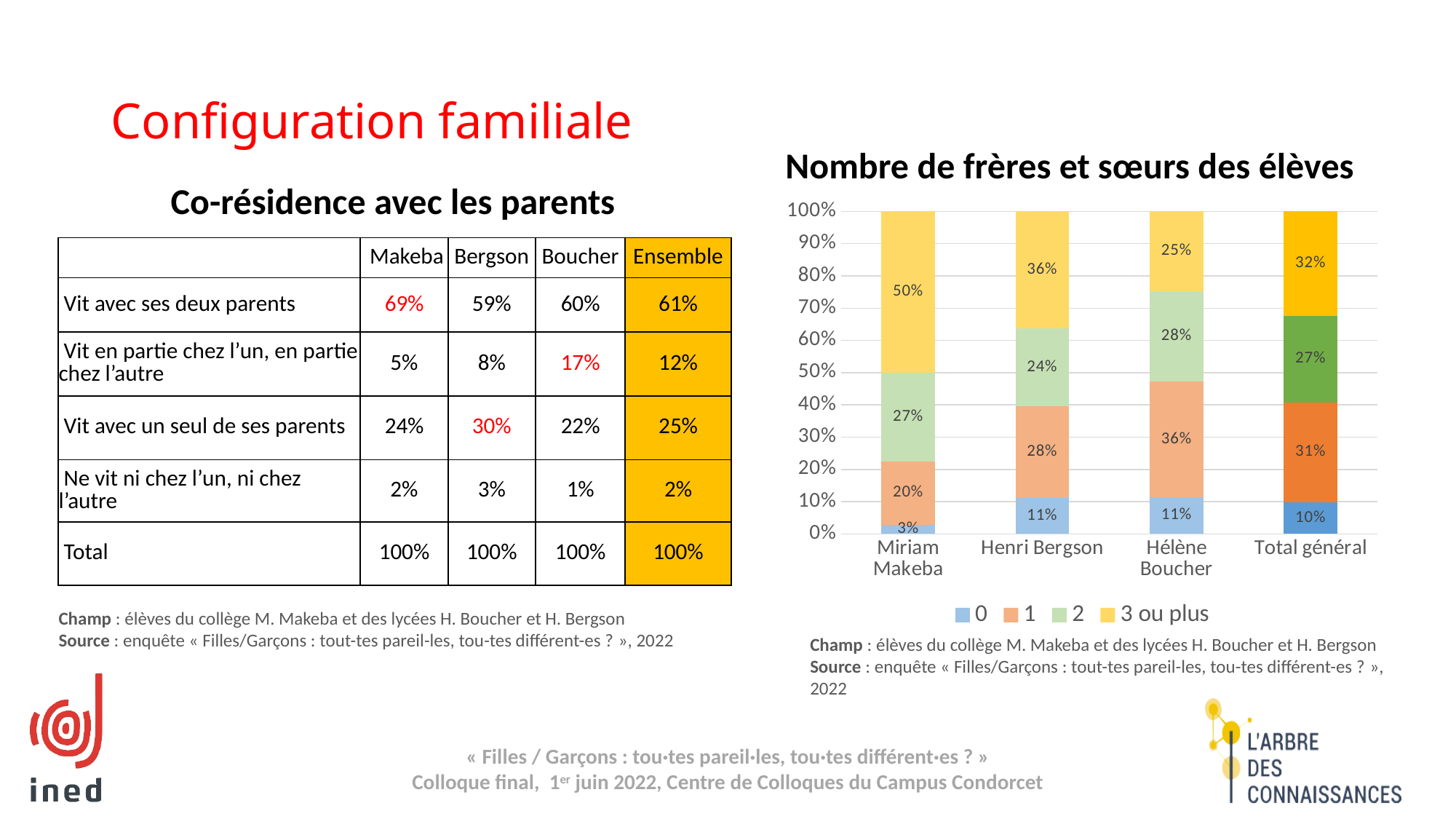
How many categories are shown on the x axis of the chart 'Nombre de frères et sœurs des élèves'? 4 In the chart 'Nombre de frères et sœurs des élèves', what is the legend entry shown in yellow? 3 ou plus In the chart 'Nombre de frères et sœurs des élèves', which category has the lowest value for the '0' series? Miriam Makeba In the chart 'Nombre de frères et sœurs des élèves', what is the value of the '1' series for Hélène Boucher? 36% In the chart 'Nombre de frères et sœurs des élèves', what is the value of the '3 ou plus' series for Miriam Makeba? 50% In the chart 'Nombre de frères et sœurs des élèves', what is the value of the '2' series for Total général? 27% In the chart 'Nombre de frères et sœurs des élèves', what is the value of the '0' series for Henri Bergson? 11% In the chart 'Nombre de frères et sœurs des élèves', is the '1' value larger for Henri Bergson or for Hélène Boucher? Hélène Boucher In the chart 'Nombre de frères et sœurs des élèves', which category has the highest value for the '3 ou plus' series? Miriam Makeba In the chart 'Nombre de frères et sœurs des élèves', what is the difference between the '3 ou plus' values for Miriam Makeba and Hélène Boucher? 25% What kind of chart is 'Nombre de frères et sœurs des élèves'? Stacked bar chart How many series does the legend of the chart 'Nombre de frères et sœurs des élèves' list? 4